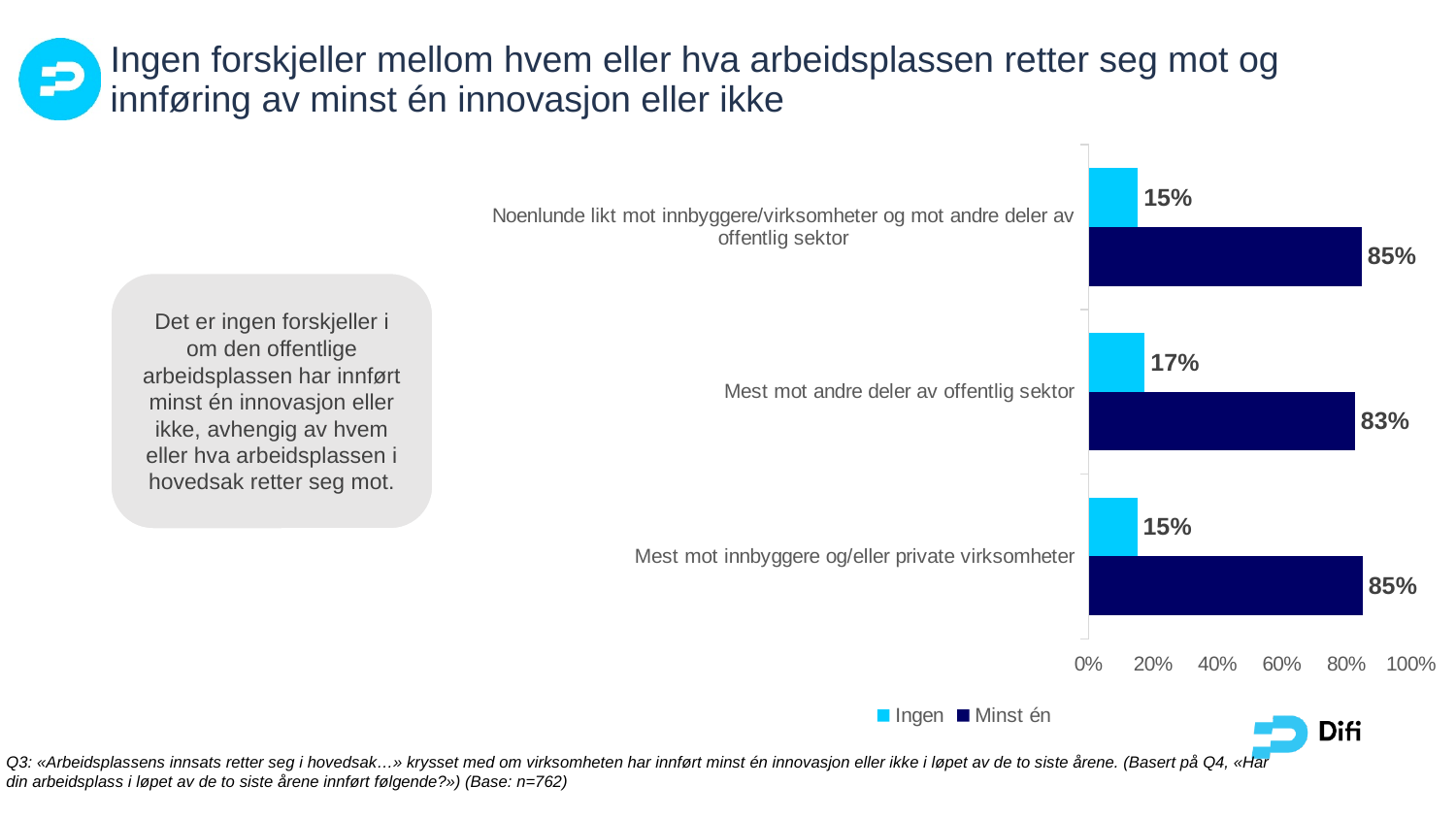
What is the value for "Minst én" in the category "Mest mot innbyggere og/eller private virksomheter"? 85% What kind of chart is shown on the slide? Bar chart Which category has the lowest value for "Minst én"? Mest mot andre deler av offentlig sektor What is the value for "Ingen" in the category "Mest mot andre deler av offentlig sektor"? 17% Is the value for "Minst én" in the category "Mest mot andre deler av offentlig sektor" greater or less than 60%? greater What is the value for "Ingen" in the category "Noenlunde likt mot innbyggere/virksomheter og mot andre deler av offentlig sektor"? 15% How many series does the legend list? 2 Which category has the highest value for "Ingen"? Mest mot andre deler av offentlig sektor How many categories are shown on the chart? 3 In the category "Mest mot innbyggere og/eller private virksomheter", which series has the larger value, "Ingen" or "Minst én"? Minst én What is the difference between the "Minst én" and "Ingen" values in the category "Mest mot andre deler av offentlig sektor"? 66% What is the value for "Minst én" in the category "Mest mot andre deler av offentlig sektor"? 83%